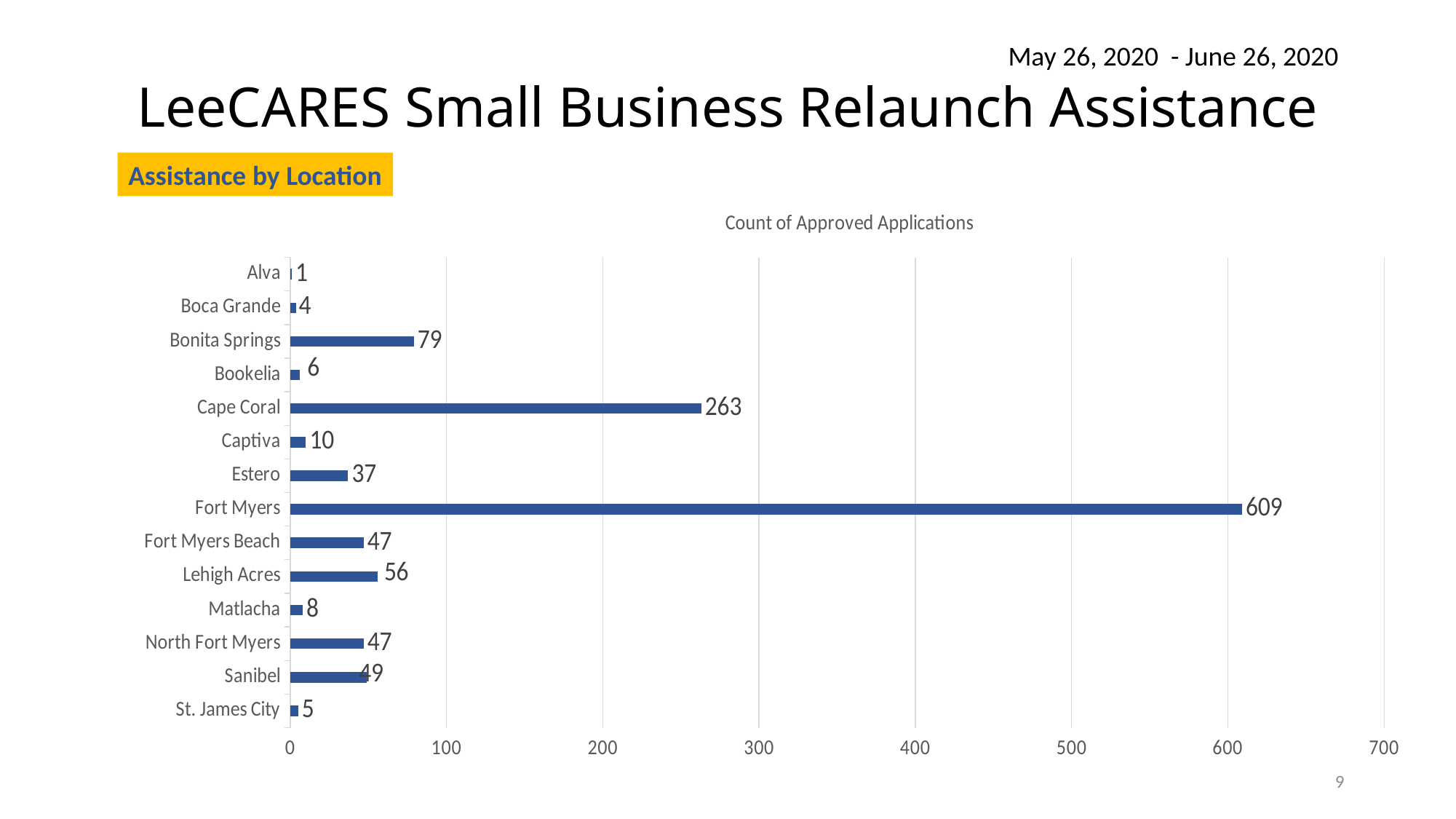
What is the title of the chart? Count of Approved Applications What is the difference between the counts for Fort Myers and Cape Coral? 346 What is the count of approved applications for Cape Coral? 263 Which has more approved applications, Sanibel or Fort Myers Beach? Sanibel How many locations are shown in the chart? 14 What is the count of approved applications for Bonita Springs? 79 What is the difference between the counts for Bonita Springs and Estero? 42 Is the value for Fort Myers greater or less than 600? greater Which location has the highest count of approved applications? Fort Myers Which location has the lowest count of approved applications? Alva What kind of chart is shown on the slide? bar chart What is the count of approved applications for Lehigh Acres? 56